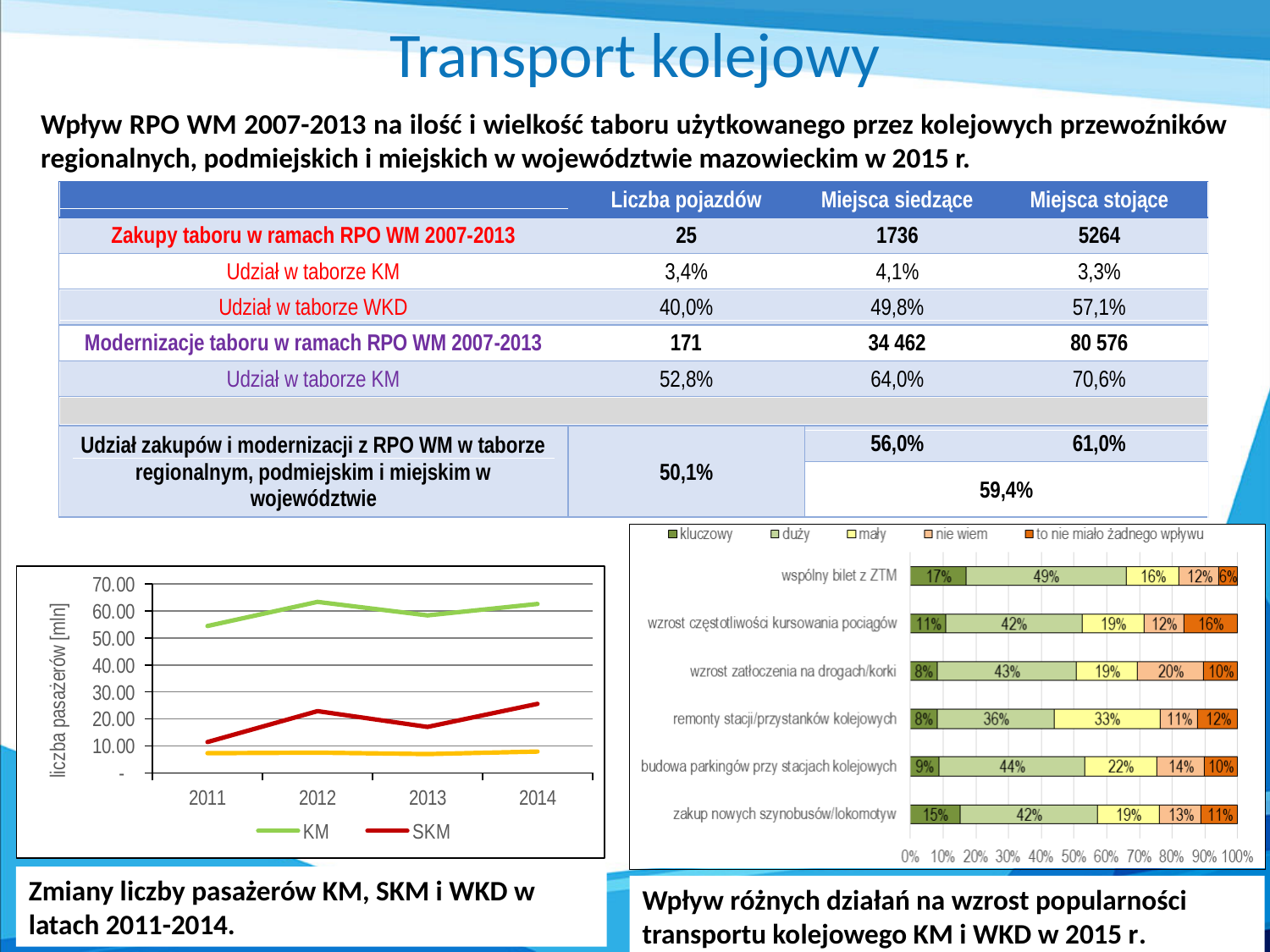
In the line chart at the bottom left, does the KM line rise or fall from 2011 to 2012? rise In the line chart at the bottom left, is the value for SKM in 2011 greater or less than 20? less In the stacked bar chart on the right, what percentage of respondents rated 'wspólny bilet z ZTM' as 'kluczowy'? 17% In the stacked bar chart on the right, what is the difference between the 'duży' share for 'wspólny bilet z ZTM' and for 'remonty stacji/przystanków kolejowych'? 13 percentage points In the line chart at the bottom left, is the value for KM in 2011 greater or less than 50? greater In the line chart at the bottom left, is the value for SKM in 2012 greater or less than 20? greater In the line chart at the bottom left, how many years are shown on the x axis? 4 In the stacked bar chart on the right, how many actions (categories) are shown? 6 In the stacked bar chart on the right, what is the 'duży' share for 'remonty stacji/przystanków kolejowych'? 36% In the stacked bar chart on the right, which action has the highest 'kluczowy' share? wspólny bilet z ZTM In the line chart at the bottom left, which series has the higher value in 2014, KM or SKM? KM In the stacked bar chart on the right, how many series does the legend list? 5